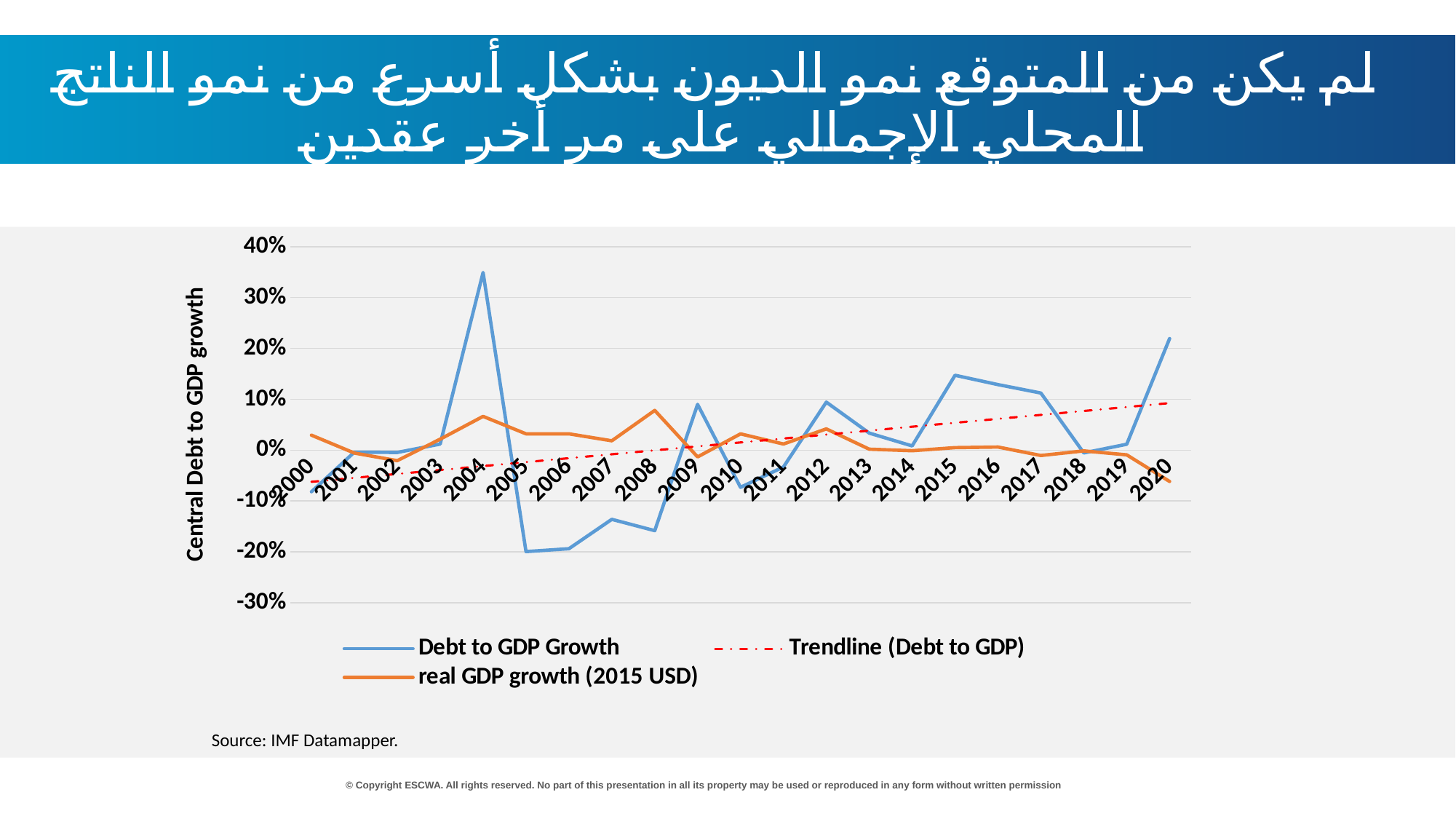
Does the Trendline (Debt to GDP) rise or fall from 2000 to 2020? rise In which year is Debt to GDP Growth lowest? 2005 What is the title of the vertical axis? Central Debt to GDP growth What kind of chart is shown on the slide? line chart Is the Debt to GDP Growth value for 2004 greater or less than 30%? greater Is the real GDP growth (2015 USD) value for 2020 greater or less than 0%? less In 2005, which is larger: Debt to GDP Growth or real GDP growth (2015 USD)? real GDP growth (2015 USD) In which year is Debt to GDP Growth highest? 2004 How many series does the legend list? 3 How many years are shown on the x axis? 21 Is the Debt to GDP Growth value for 2015 greater or less than 10%? greater